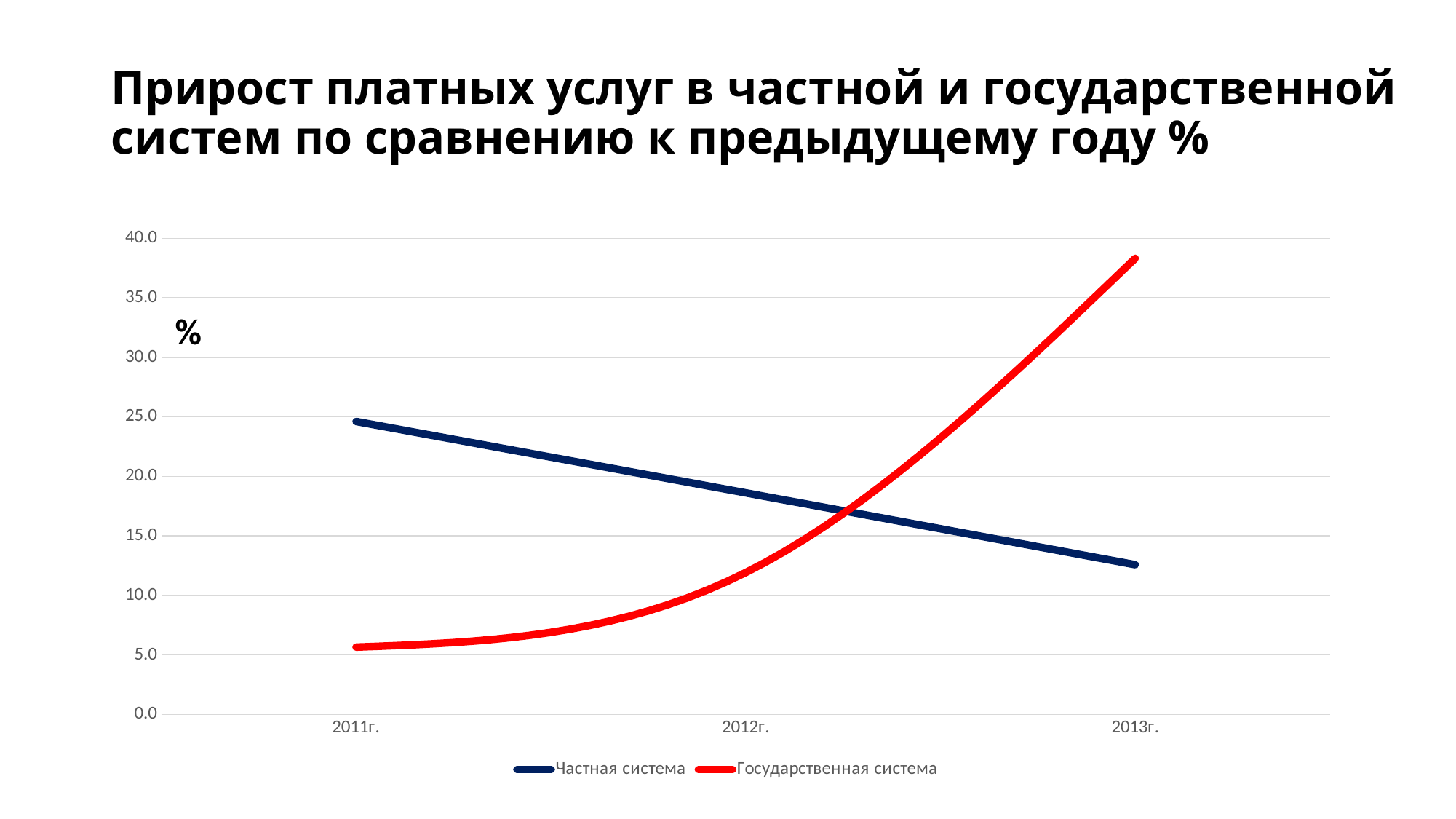
What kind of chart is shown on the slide? line chart How many years are shown on the x axis? 3 Does the value for Частная система rise or fall from 2011г. to 2013г.? fall Which series has the larger value in 2013г., Частная система or Государственная система? Государственная система How many series does the legend list? 2 Does the value for Государственная система rise or fall from 2011г. to 2013г.? rise Is the value for Государственная система in 2011г. greater or less than 10.0? less Is the value for Частная система in 2011г. greater or less than 20.0? greater Which series has the larger value in 2011г., Частная система or Государственная система? Частная система In which year is the value for Государственная система highest? 2013г. Which colour is used for the Государственная система line? red Is the value for Государственная система in 2013г. greater or less than 35.0? greater